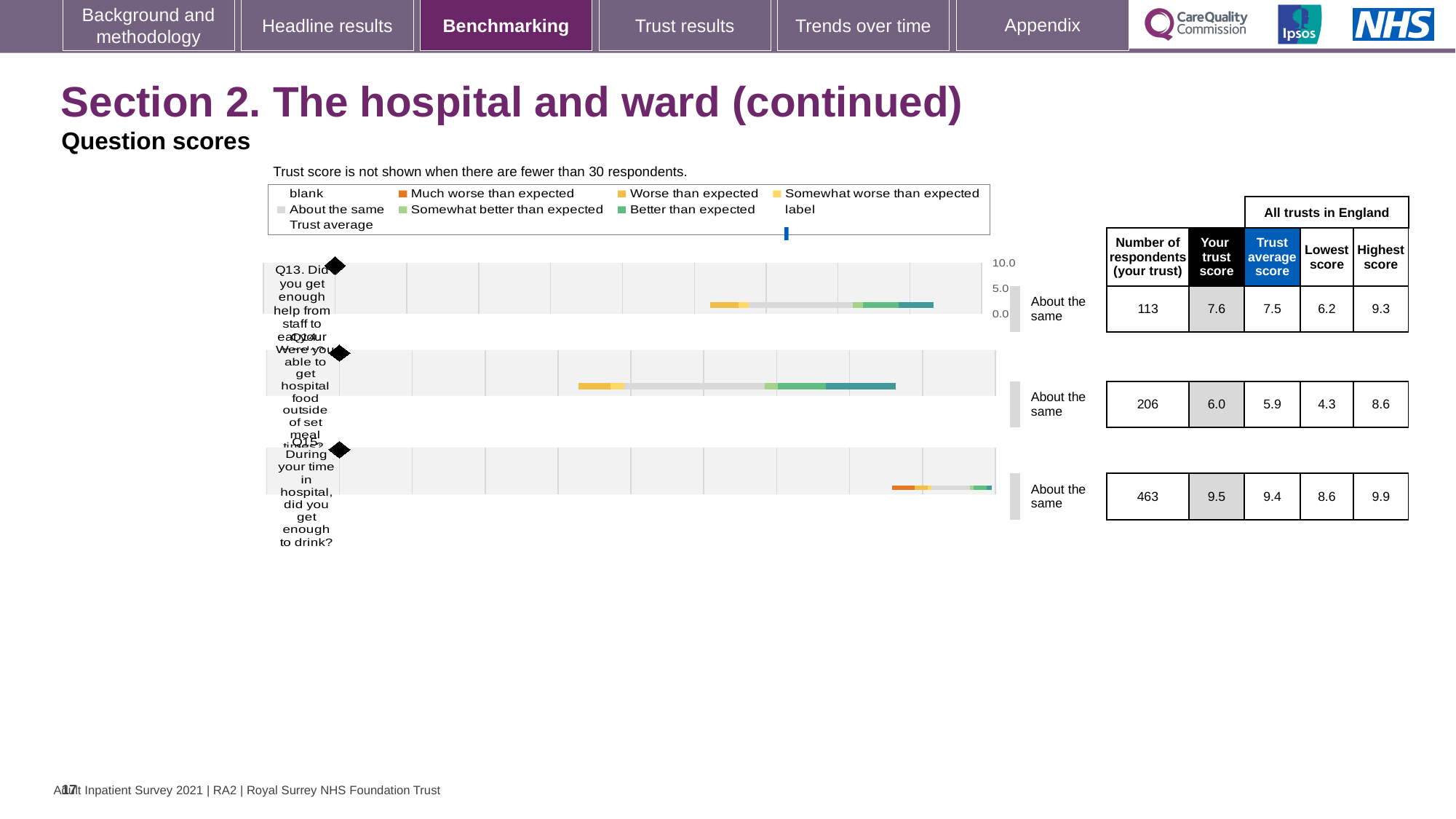
Which question has the highest 'Your trust score'? Q15 For Q13, which is larger: the 'Your trust score' or the 'Trust average score'? Your trust score Which legend entry is shown in dark orange? Much worse than expected For Q14, what is the difference between the highest score and the lowest score across all trusts in England? 4.3 What kind of chart is used to show the question scores for Q13, Q14 and Q15? bar chart How many questions are plotted on the slide? 3 Which question has the lowest number of respondents? Q13 What is the lowest score across all trusts in England for Q15? 8.6 What benchmark category is shown next to the Q14 bar? About the same What is the 'Your trust score' for Q13 (Did you get enough help from staff to eat your meals?)? 7.6 How many respondents answered Q15 (During your time in hospital, did you get enough to drink?)? 463 What is the trust average score for Q14 (Were you able to get hospital food outside of set meal times?)? 5.9